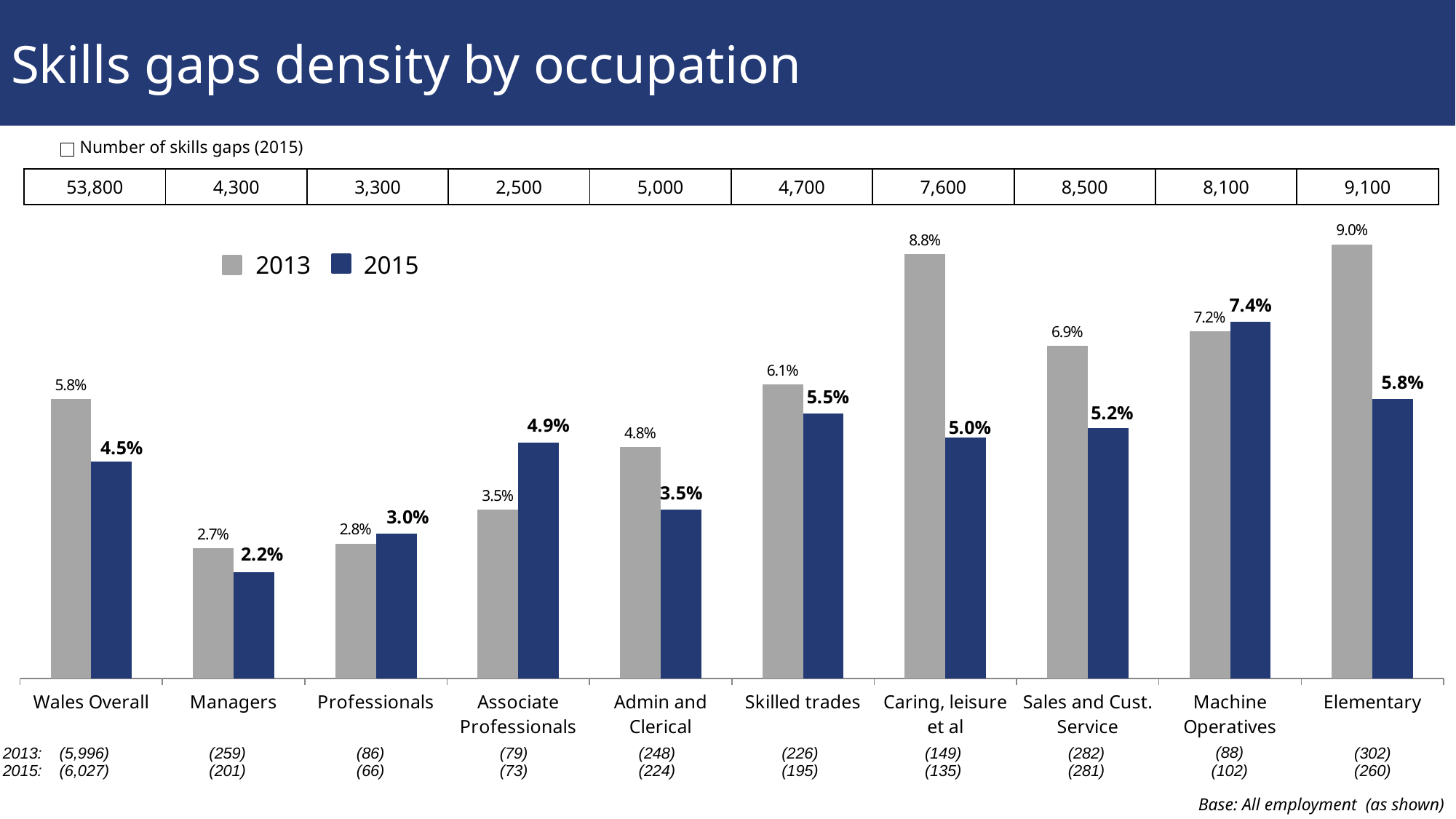
What is the 2013 skills gap density for Caring, leisure et al? 8.8% Which occupation has the highest 2013 skills gap density? Elementary Which occupation has the lowest 2015 skills gap density? Managers How many occupation categories are shown on the x axis? 10 What is the difference between the 2013 and 2015 skills gap density for Elementary? 3.2% What kind of chart is shown on the slide? Bar chart Which is larger for Associate Professionals, the 2013 value or the 2015 value? 2015 What is the number of skills gaps (2015) shown for Elementary? 9,100 What is the 2015 skills gap density for Wales Overall? 4.5% How many series does the legend list? 2 Which colour represents the 2013 series in the legend? Grey What is the 2015 skills gap density for Machine Operatives? 7.4%